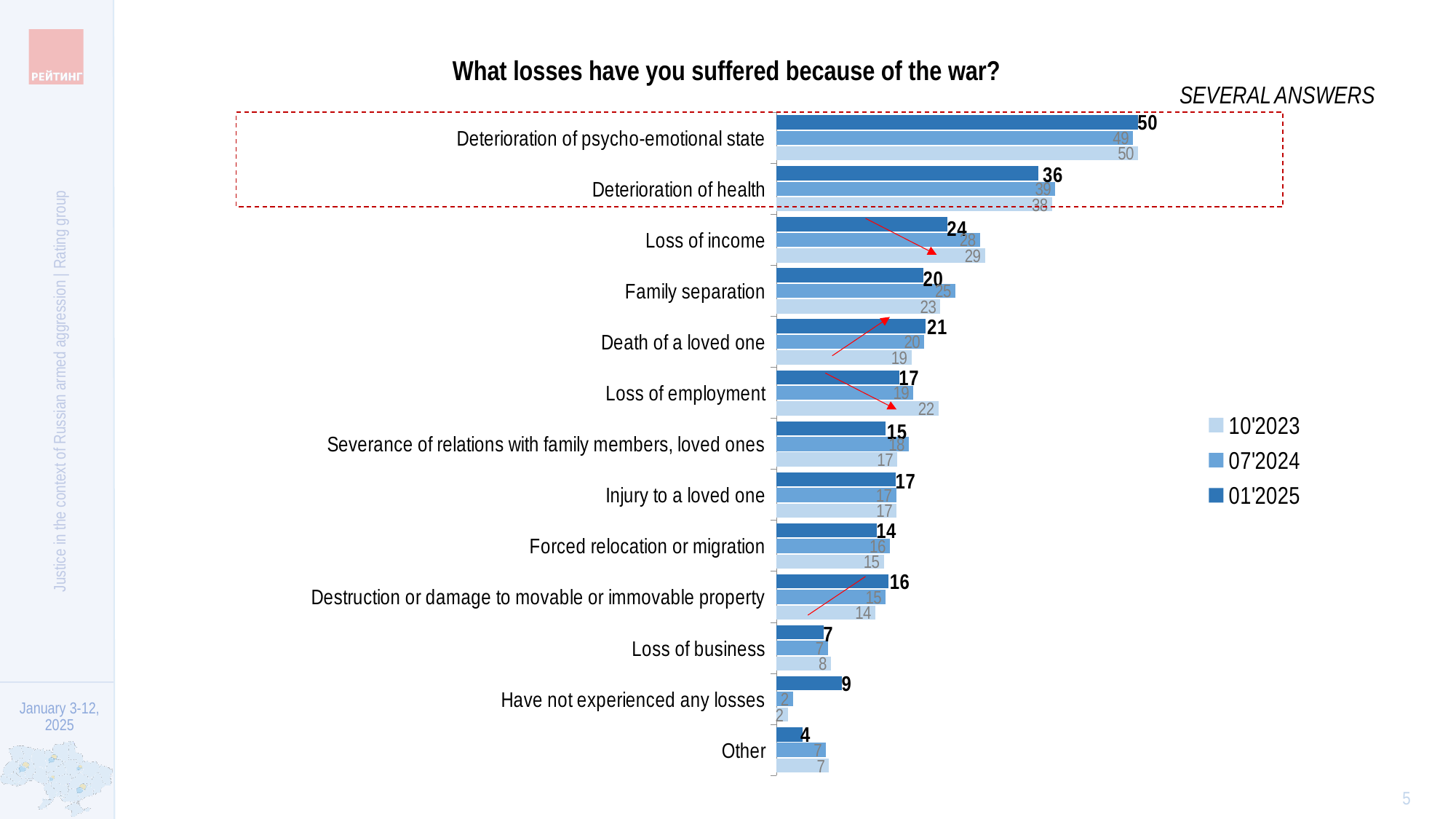
What is the value for Loss of income in the 10'2023 series? 29 What is the value for Have not experienced any losses in the 01'2025 series? 9 What is the title of the chart? What losses have you suffered because of the war? Which category has the highest value in the 01'2025 series? Deterioration of psycho-emotional state Which is larger for Loss of employment: the 10'2023 value or the 01'2025 value? 10'2023 How many series does the legend list? 3 How many categories are shown on the chart? 13 What is the value for Deterioration of health in the 07'2024 series? 39 What kind of chart is shown on the slide? Bar chart Which category has the lowest value in the 01'2025 series? Other What is the value for Deterioration of psycho-emotional state in the 01'2025 series? 50 What is the difference between the 01'2025 values for Deterioration of psycho-emotional state and Deterioration of health? 14